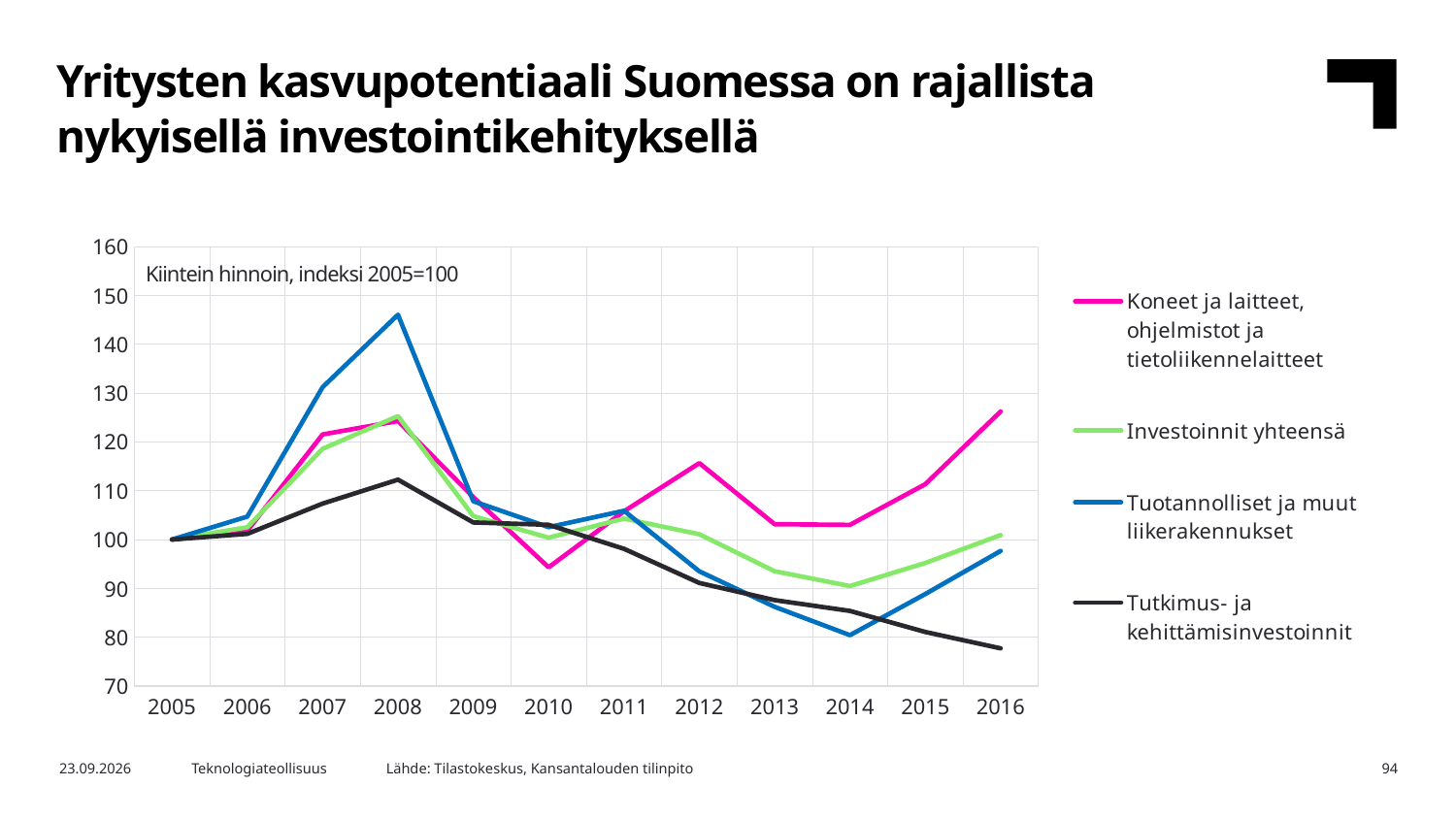
What note is printed inside the plot area of the chart? Kiintein hinnoin, indeksi 2005=100 Which series has the lowest value in 2016? Tutkimus- ja kehittämisinvestoinnit Which series has the highest value in 2016? Koneet ja laitteet, ohjelmistot ja tietoliikennelaitteet Does the Tutkimus- ja kehittämisinvestoinnit series rise or fall from 2008 to 2016? fall Is the value for Koneet ja laitteet, ohjelmistot ja tietoliikennelaitteet in 2010 greater or less than 100? less Which series has the highest value in 2008? Tuotannolliset ja muut liikerakennukset Is the value for Tuotannolliset ja muut liikerakennukset in 2008 greater or less than 140? greater Is the value for Tutkimus- ja kehittämisinvestoinnit in 2016 greater or less than 80? less What kind of chart is shown on the slide? line chart What is the value of every series in 2005? 100 How many series does the legend list? 4 How many years are shown on the x axis? 12